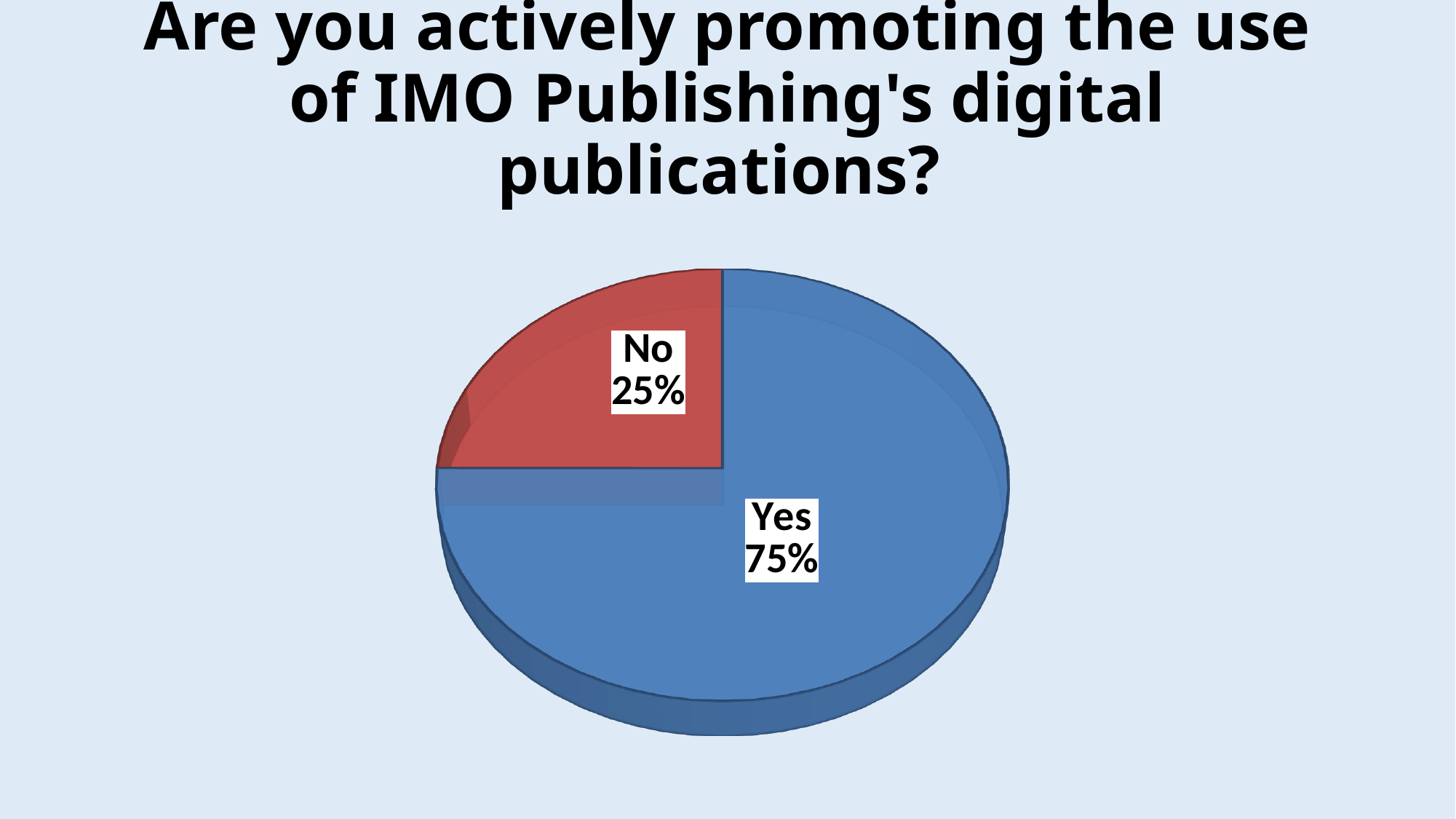
Which response has the largest share of the pie? Yes How many slices does the pie chart have? 2 What kind of chart is shown on the slide? pie chart Which response has the smallest share of the pie? No What percentage of respondents answered Yes? 75% Which slice is larger, Yes or No? Yes What is the difference in percentage points between the Yes and No slices? 50 What colour is the No slice? red What share of the pie does the Yes slice represent? 75% What percentage of respondents answered No? 25% What is the title of the chart? Are you actively promoting the use of IMO Publishing's digital publications?